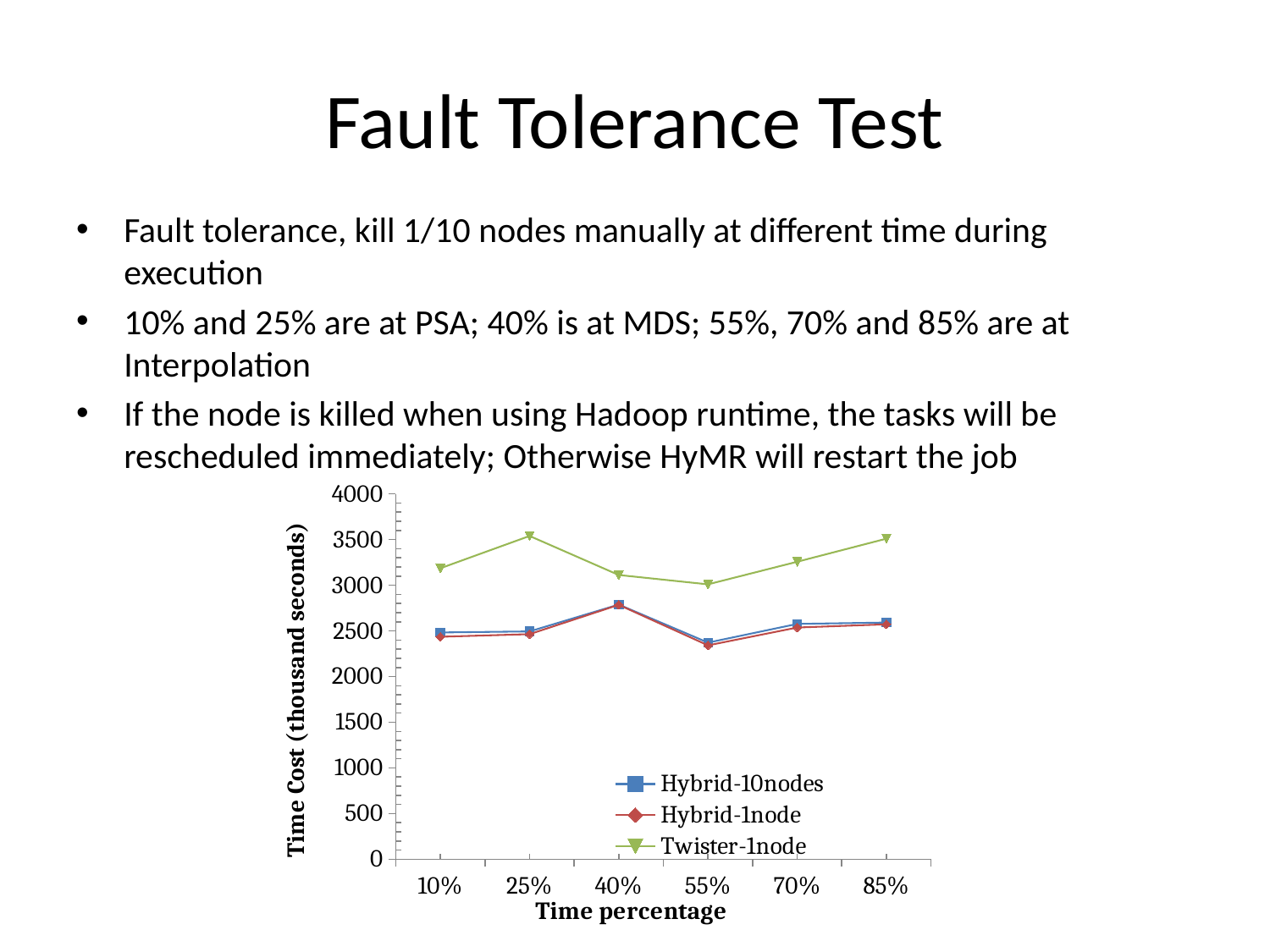
Is the value for Twister-1node at 10% greater or less than 3000? greater What is the title of the x axis? Time percentage What kind of chart is shown on the slide? line chart Which is larger at 70%: the value for Twister-1node or the value for Hybrid-1node? Twister-1node How many series does the legend list? 3 Is the value for Hybrid-1node at 55% greater or less than 2500? less How many time percentage categories are plotted on the x axis? 6 At which time percentage does Hybrid-10nodes reach its highest time cost? 40% Is the value for Twister-1node at 85% greater or less than 4000? less What is the title of the y axis? Time Cost (thousand seconds) Which series has the highest time cost at every time percentage? Twister-1node